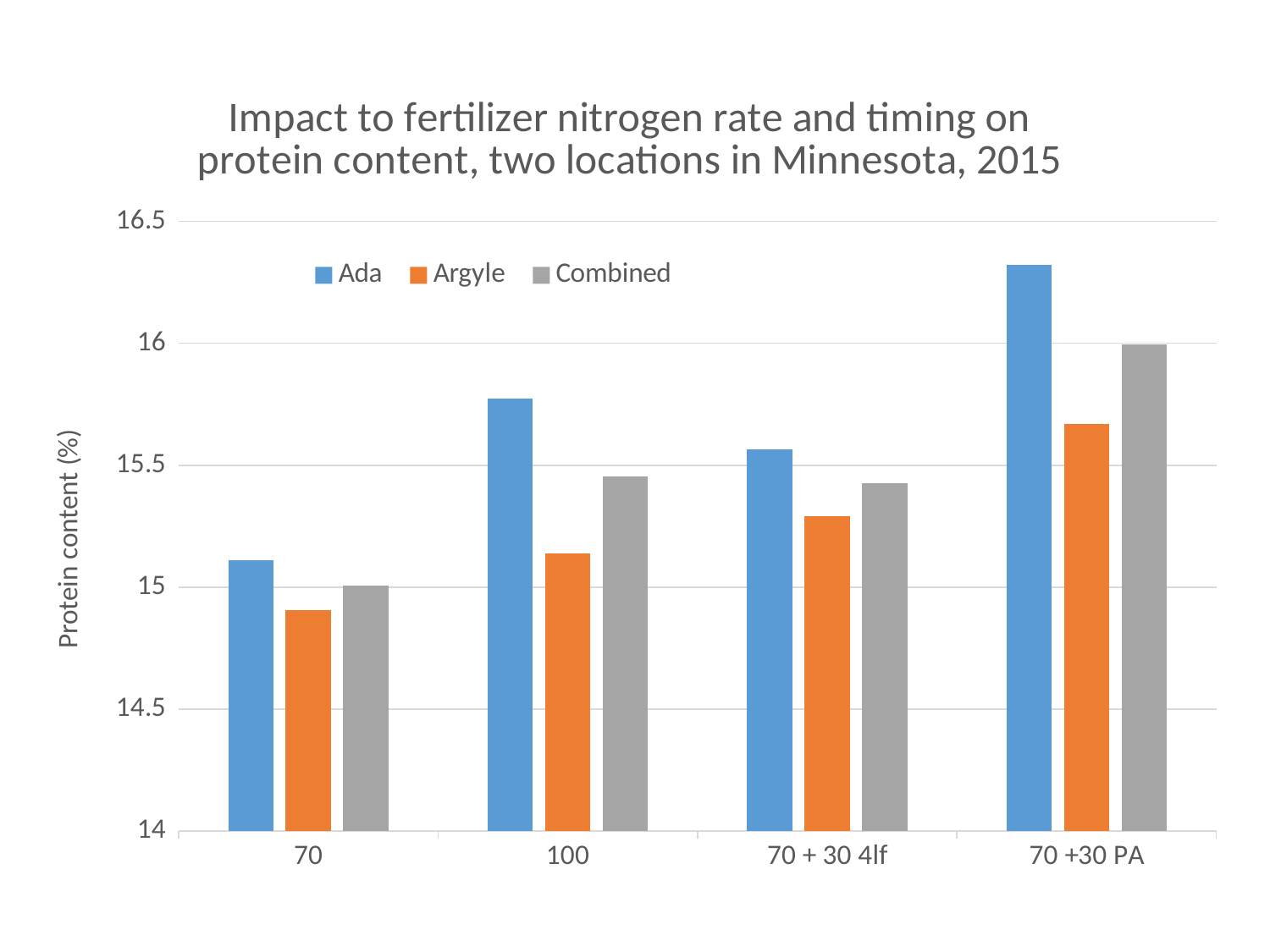
At the 100 category, which is larger, Ada or Argyle? Ada Is the value for Ada at 100 greater or less than 15.5? greater What is the label of the y axis? Protein content (%) Which series are listed in the legend? Ada, Argyle, Combined Is the value for Argyle at 70 + 30 4lf greater or less than 15? greater How many categories are shown on the x axis? 4 For which category is the Ada value highest? 70 +30 PA What kind of chart is shown on the slide? bar chart Is the value for Ada at 70 +30 PA greater or less than 16? greater For which category is the Argyle value lowest? 70 How many series does the legend list? 3